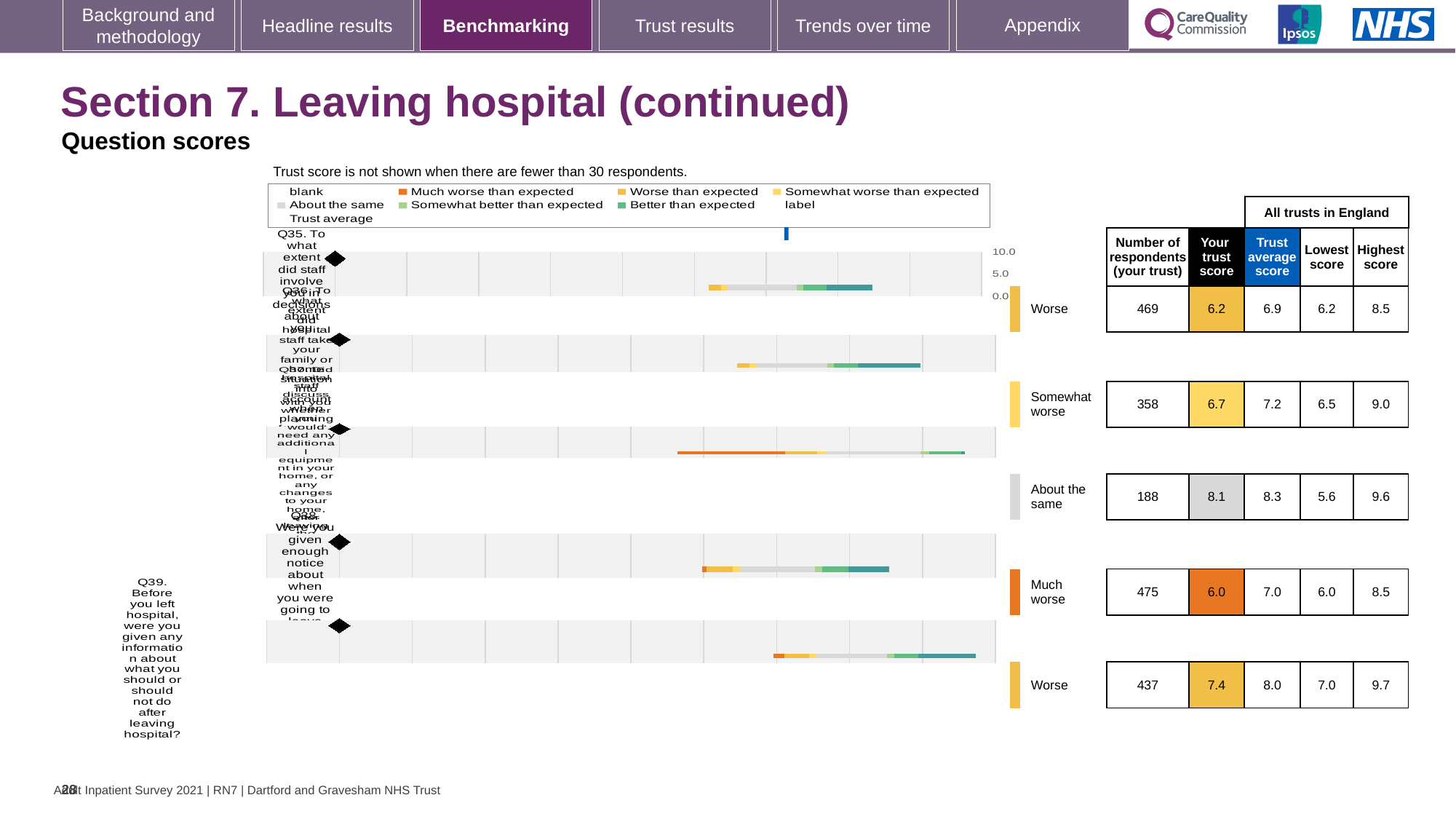
What is the 'Highest score' for Q39 (the last row of the table)? 9.7 What kind of chart is used to show the question scores? Bar chart How many questions (rows) are shown in the chart? 5 What is the 'Your trust score' for Q35 (the first row of the table)? 6.2 For Q39 (the last row), what is the difference between the 'Trust average score' and the 'Your trust score'? 0.6 How many respondents does the table show for Q35 (the first row)? 469 What is the 'Your trust score' in the row rated 'About the same'? 8.1 What is the 'Your trust score' for Q39 (the last row of the table)? 7.4 What is the 'Trust average score' in the row rated 'Much worse'? 7.0 Which rating row has the highest 'Your trust score' in the table? About the same Which rating row has the lowest 'Your trust score' in the table? Much worse For Q35 (the first row), which is larger: the 'Your trust score' or the 'Trust average score'? Trust average score